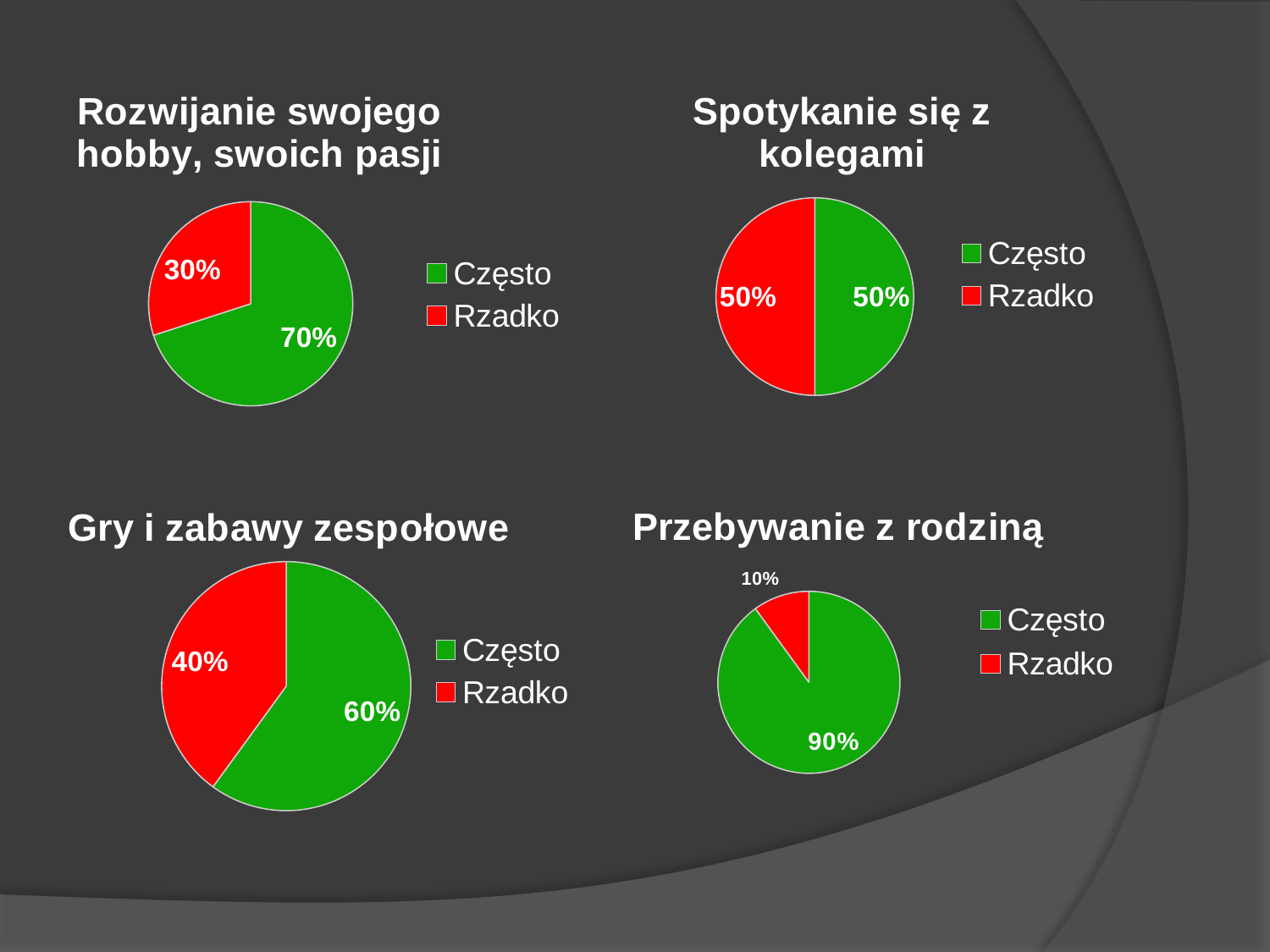
What type of chart is 'Spotykanie się z kolegami'? Pie chart In the 'Rozwijanie swojego hobby, swoich pasji' chart, which is larger, Często or Rzadko? Często In the 'Rozwijanie swojego hobby, swoich pasji' chart, what share is labelled for Często? 70% In the 'Rozwijanie swojego hobby, swoich pasji' chart, what share is labelled for Rzadko? 30% In the 'Przebywanie z rodziną' chart, what share is labelled for Rzadko? 10% In the 'Spotykanie się z kolegami' chart, what share is labelled for Często? 50% How many entries does the legend of the 'Przebywanie z rodziną' chart list? 2 In the 'Gry i zabawy zespołowe' chart, what is the difference between the Często and Rzadko shares? 20% In the 'Przebywanie z rodziną' chart, what share is labelled for Często? 90% In the 'Przebywanie z rodziną' chart, which category has the smallest slice? Rzadko In the 'Gry i zabawy zespołowe' chart, what share is labelled for Rzadko? 40% In the 'Gry i zabawy zespołowe' chart, which category has the largest slice? Często